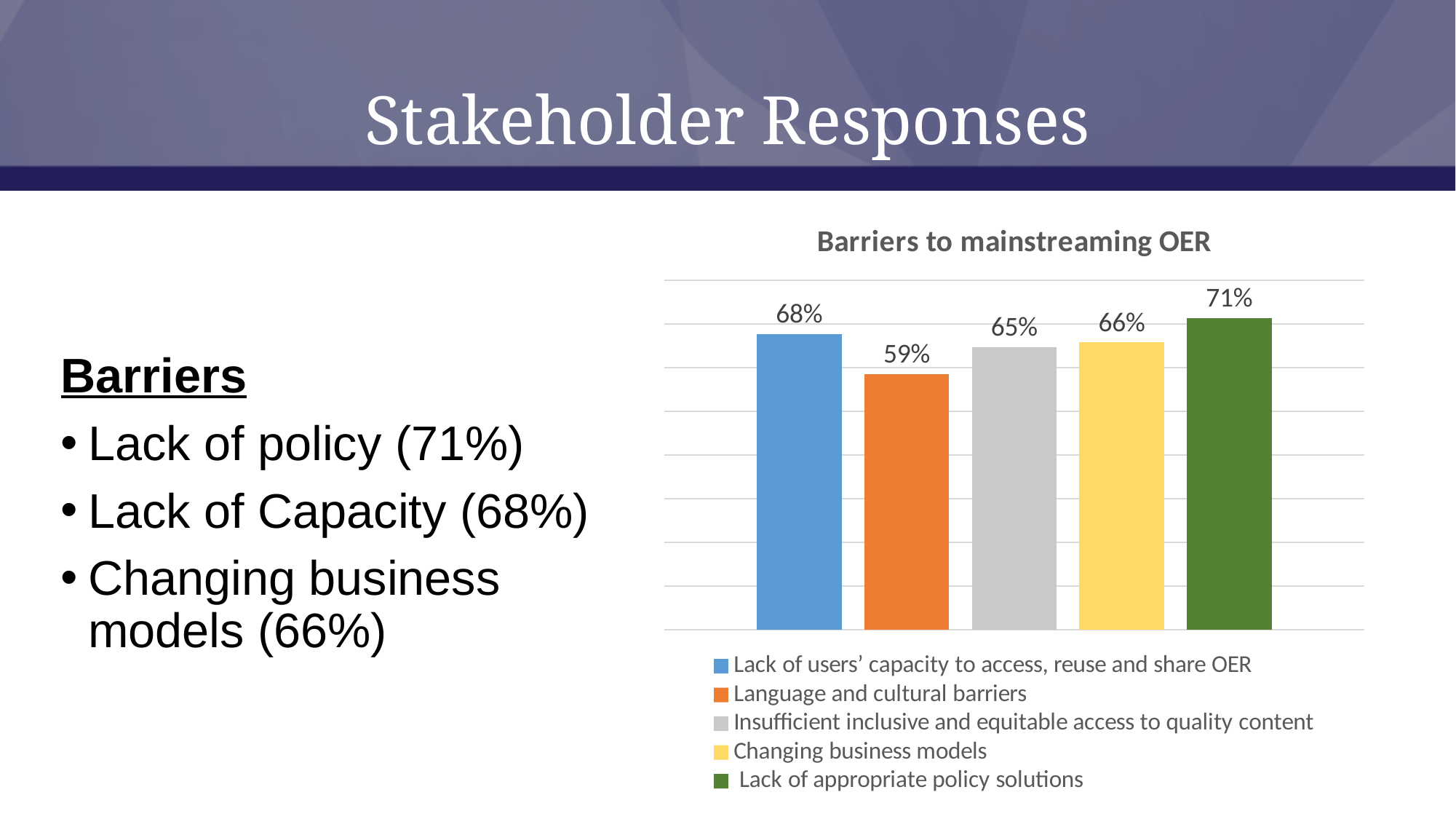
What is the title of the chart on the slide? Barriers to mainstreaming OER Which is larger: the value for 'Lack of users' capacity to access, reuse and share OER' or the value for 'Changing business models'? Lack of users' capacity to access, reuse and share OER Which barrier has the lowest value in the chart? Language and cultural barriers How many entries does the chart legend list? 5 What type of chart is shown on the slide? Bar chart What is the value for 'Lack of appropriate policy solutions' in the chart? 71% What is the value for 'Language and cultural barriers' in the Barriers to mainstreaming OER chart? 59% How many bars are shown in the Barriers to mainstreaming OER chart? 5 Which barrier has the highest value in the chart? Lack of appropriate policy solutions What is the value for 'Changing business models' in the chart? 66% What is the difference between the values for 'Lack of appropriate policy solutions' and 'Language and cultural barriers'? 12% What is the value for 'Insufficient inclusive and equitable access to quality content'? 65%